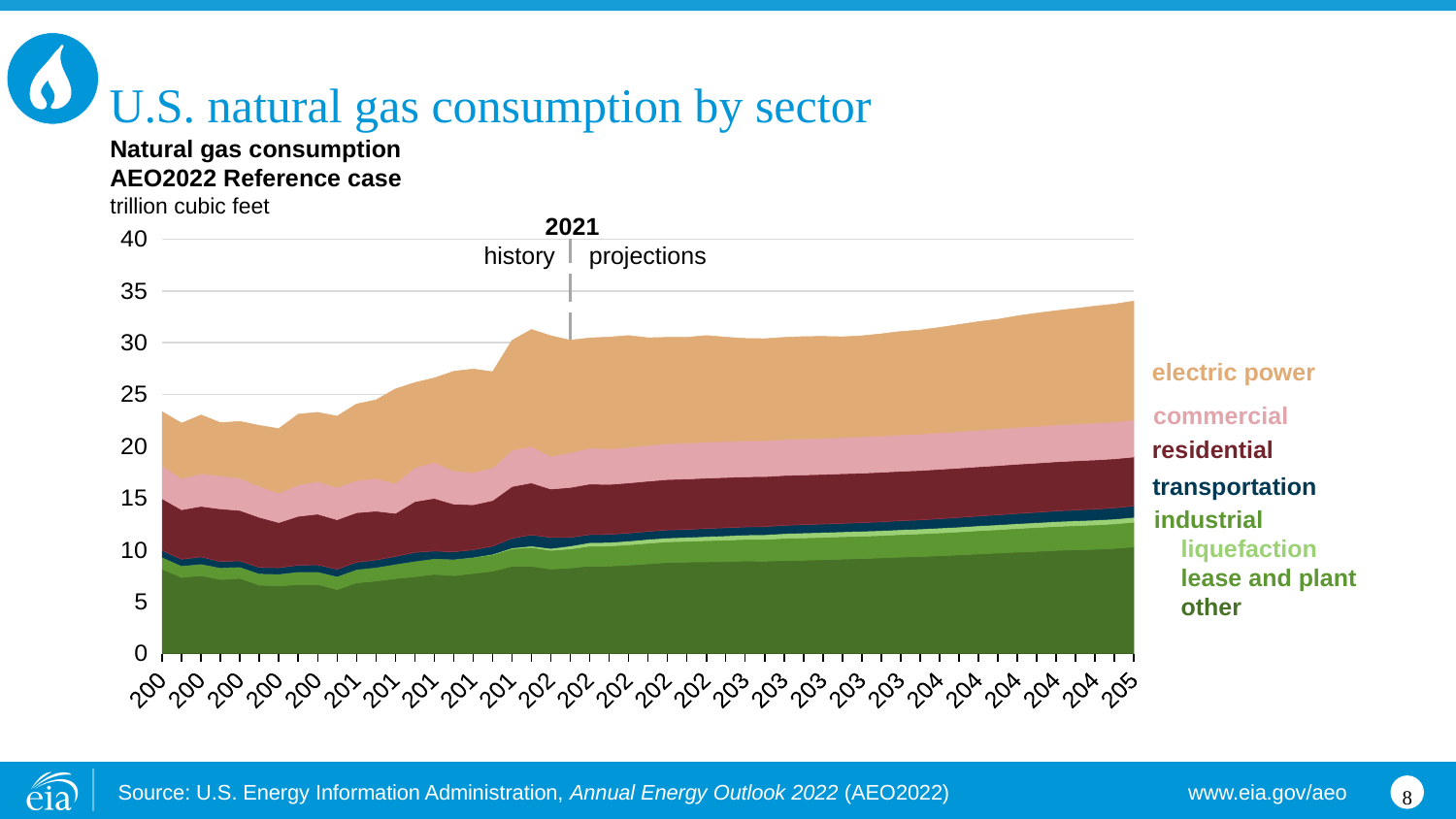
What kind of chart is shown on the slide? stacked area chart Is the total natural gas consumption at the 2021 marker greater or less than 35 trillion cubic feet? less Which year separates history from projections in the chart? 2021 Is the total natural gas consumption at the 2021 marker greater or less than 25 trillion cubic feet? greater What unit is used on the y-axis of the chart? trillion cubic feet Which sector accounts for the smallest share of natural gas consumption in the chart? transportation Which sector accounts for the largest share of natural gas consumption at the right end of the chart? industrial What is the highest value shown on the y-axis of the chart? 40 Does total natural gas consumption rise or fall over the projection period after 2021? rise Which sector consumes more natural gas at the right end of the chart, electric power or commercial? electric power Is the total natural gas consumption at the far right end of the chart greater or less than 30 trillion cubic feet? greater